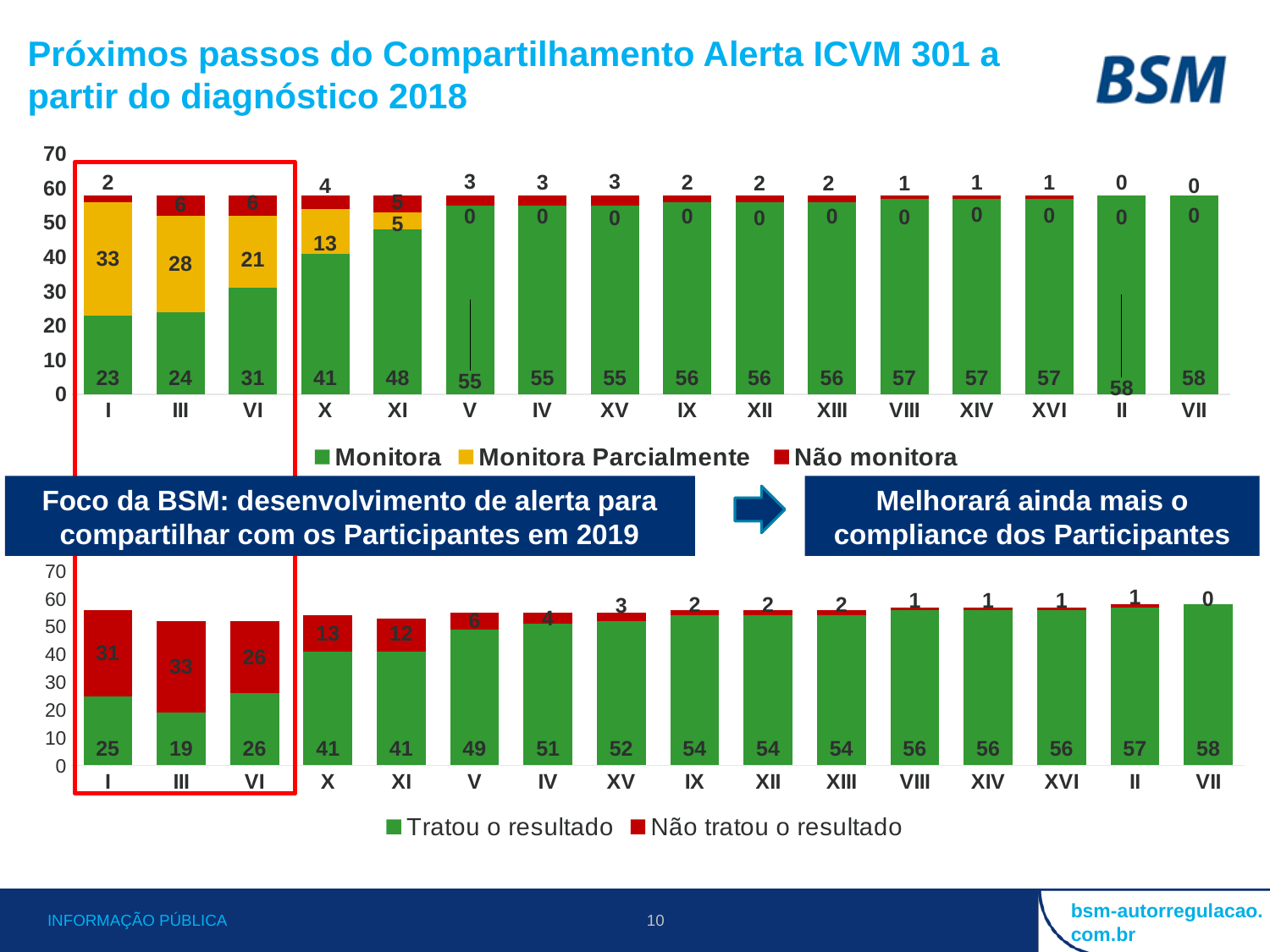
In the top chart, what is the 'Monitora Parcialmente' value for category III? 28 In the bottom chart, which category has the highest 'Não tratou o resultado' value? III In the top chart, how many series does the legend list? 3 In the bottom chart, what is the 'Tratou o resultado' value for category VII? 58 In the bottom chart, what is the 'Não tratou o resultado' value for category III? 33 In the top chart, what is the total of the stacked bar for category I? 58 In the bottom chart, what is the difference between the 'Tratou o resultado' values for categories X and I? 16 In the top chart, which category has the lowest 'Monitora' value? I In the top chart, what is the 'Não monitora' value for category X? 4 In the bottom chart, how many categories are shown on the x axis? 16 What type of chart is the bottom chart? Stacked bar chart In the top chart, what is the 'Monitora' value for category I? 23